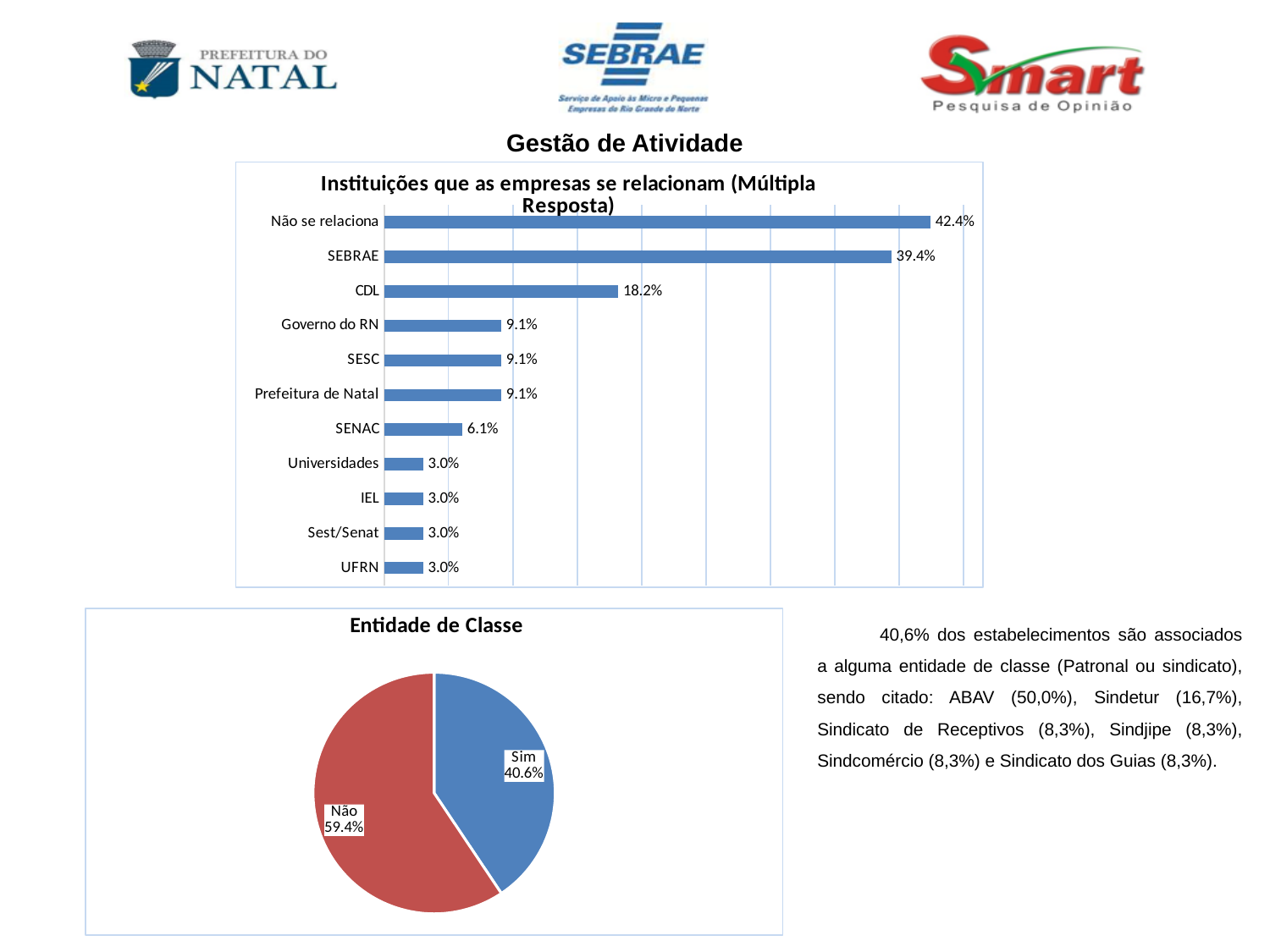
What kind of chart is the 'Instituições que as empresas se relacionam' chart? Bar chart How many categories are shown in the 'Instituições que as empresas se relacionam' chart? 11 In the 'Instituições que as empresas se relacionam' chart, what is the value for Governo do RN? 9.1% In the 'Instituições que as empresas se relacionam' chart, what is the value for CDL? 18.2% In the 'Entidade de Classe' chart, what is the difference between 'Não' and 'Sim'? 18.8% What kind of chart is the 'Entidade de Classe' chart? Pie chart In the 'Entidade de Classe' chart, what is the value for 'Sim'? 40.6% In the 'Instituições que as empresas se relacionam' chart, what is the difference between 'Não se relaciona' and SEBRAE? 3.0% In the 'Entidade de Classe' chart, what share does 'Não' have? 59.4% In the 'Instituições que as empresas se relacionam' chart, which category has the highest value? Não se relaciona In the 'Instituições que as empresas se relacionam' chart, what is the value for SEBRAE? 39.4% In the 'Instituições que as empresas se relacionam' chart, which is larger: CDL or SENAC? CDL